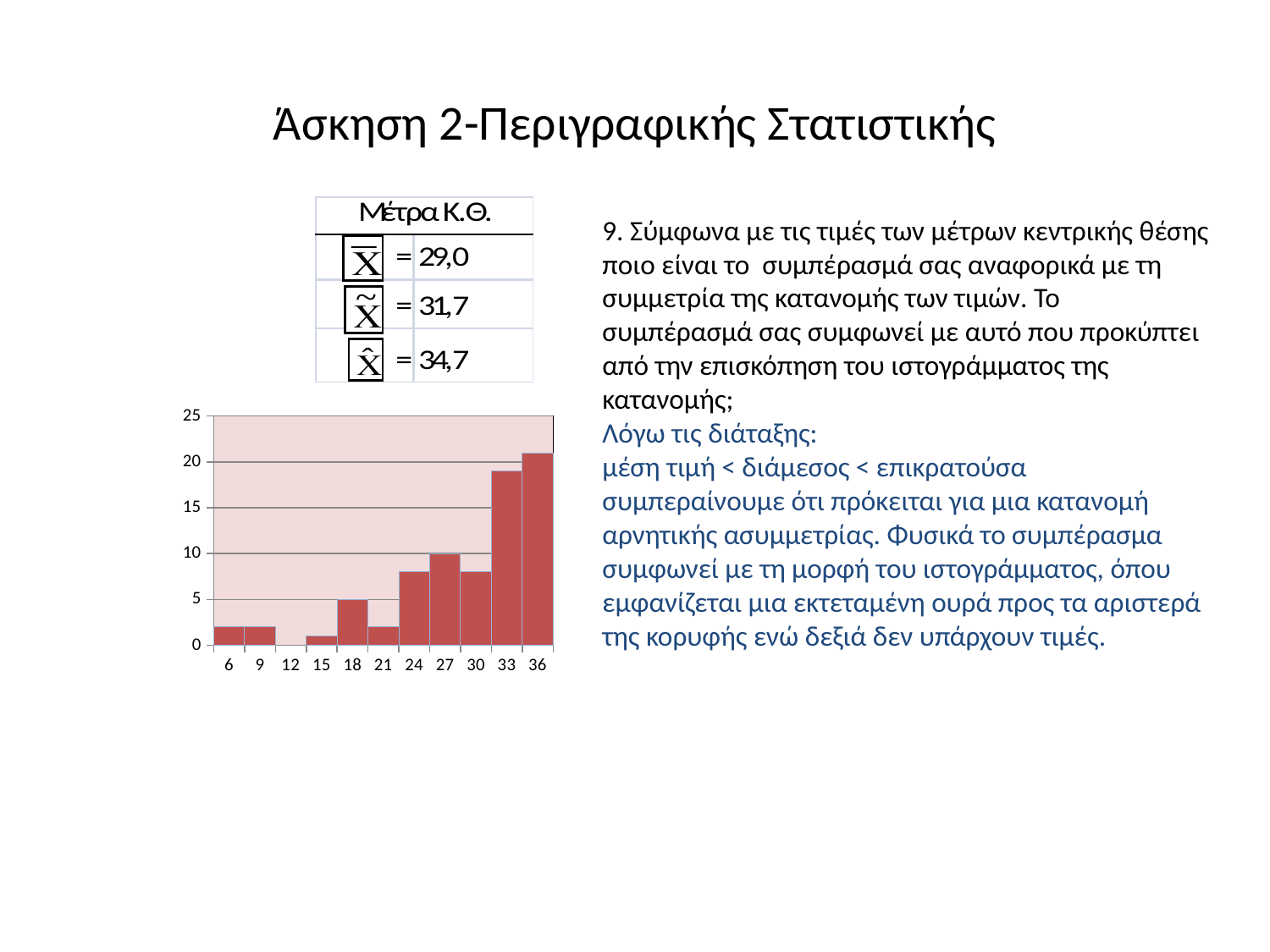
What is the highest tick value shown on the y axis of the chart? 25 Which is larger, the value for category 18 or the value for category 21? 18 Is the value for category 24 greater or less than 10? less Which category has the tallest bar in the chart? 36 What kind of chart is shown on the slide? bar chart Is the value for category 6 greater or less than 5? less Which is larger, the value for category 33 or the value for category 30? 33 Is the value for category 30 greater or less than 5? greater How many categories are labelled on the x axis of the chart? 11 Do the bar heights generally rise or fall moving from left to right along the x axis? rise